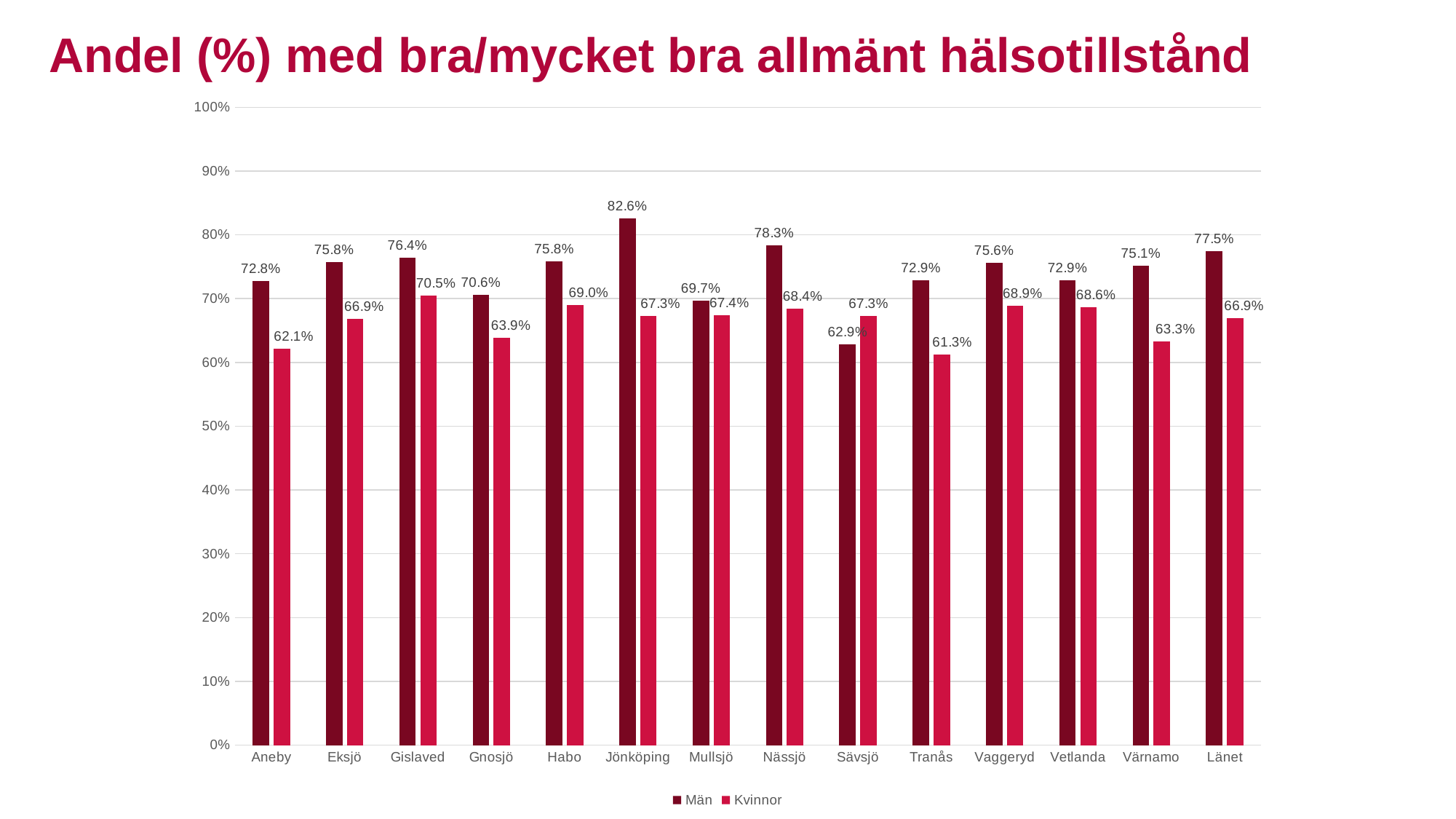
Which municipality has the highest value for Män? Jönköping How many series does the legend list? 2 What is the value for Kvinnor in Tranås? 61.3% Which category has the highest value for Kvinnor? Gislaved In Sävsjö, which is larger: the value for Män or for Kvinnor? Kvinnor What is the difference between Män and Kvinnor in Jönköping? 15.3 percentage points What kind of chart is shown on the slide? Bar chart Which category has the lowest value for Män? Sävsjö What is the value for Kvinnor in Länet? 66.9% Which category has the lowest value for Kvinnor? Tranås What is the value for Män in Jönköping? 82.6% How many categories are shown on the x axis? 14